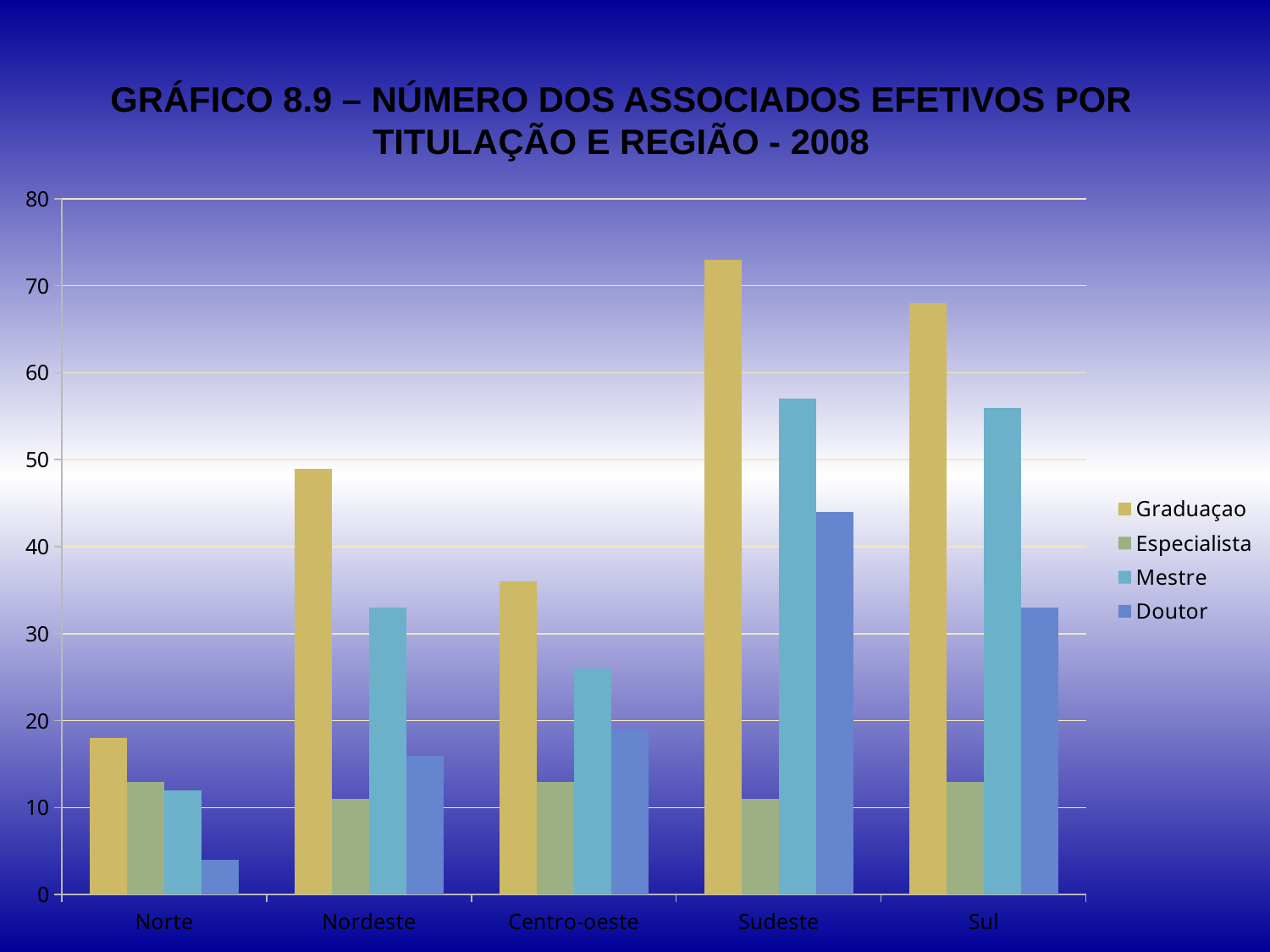
Is the value for Graduaçao in Sudeste greater or less than 70? greater Which series has the highest value in the Sul region? Graduaçao Is the value for Doutor in Sudeste greater or less than 40? greater Which region has the lowest value for Doutor? Norte Which region has the highest value for Graduaçao? Sudeste How many regions are shown on the x axis? 5 What kind of chart is shown on the slide? bar chart Is the value for Mestre in Nordeste greater or less than 30? greater Which region has the lowest value for Graduaçao? Norte Which is larger, the Graduaçao value for Nordeste or for Centro-oeste? Nordeste How many series does the legend list? 4